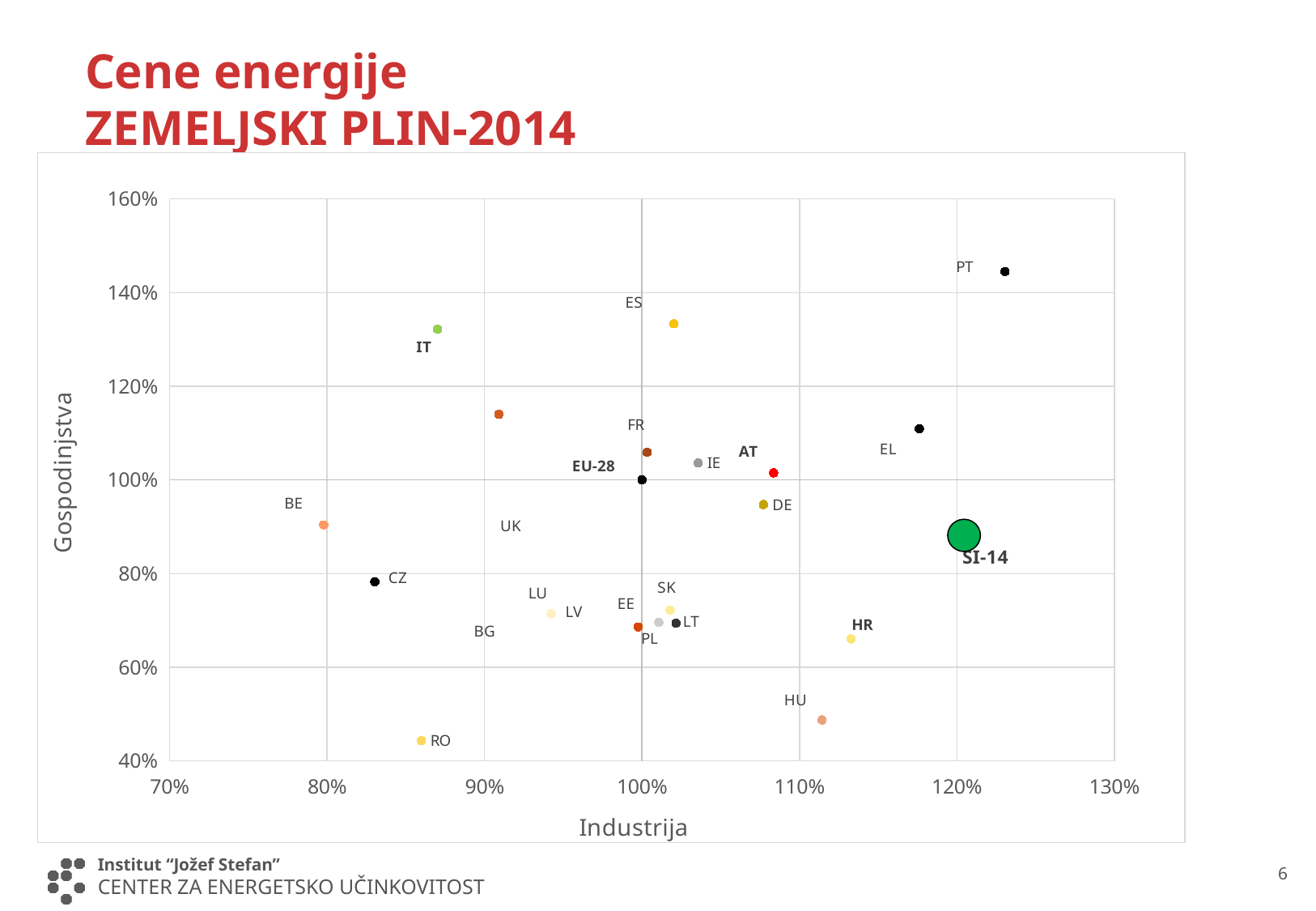
Is the Industrija value for EL greater or less than 110%? greater Which country has the lowest Gospodinjstva value in the chart? RO Which country has the highest Gospodinjstva value in the chart? PT What is the title of the y axis of the chart? Gospodinjstva Is the Gospodinjstva value for HU greater or less than 60%? less Which has the higher Gospodinjstva value, PT or ES? PT Is the Industrija value for IT greater or less than 90%? less What is the title of the x axis of the chart? Industrija What kind of chart is shown on the slide? scatter chart Which point has the lowest Industrija value in the chart? BE